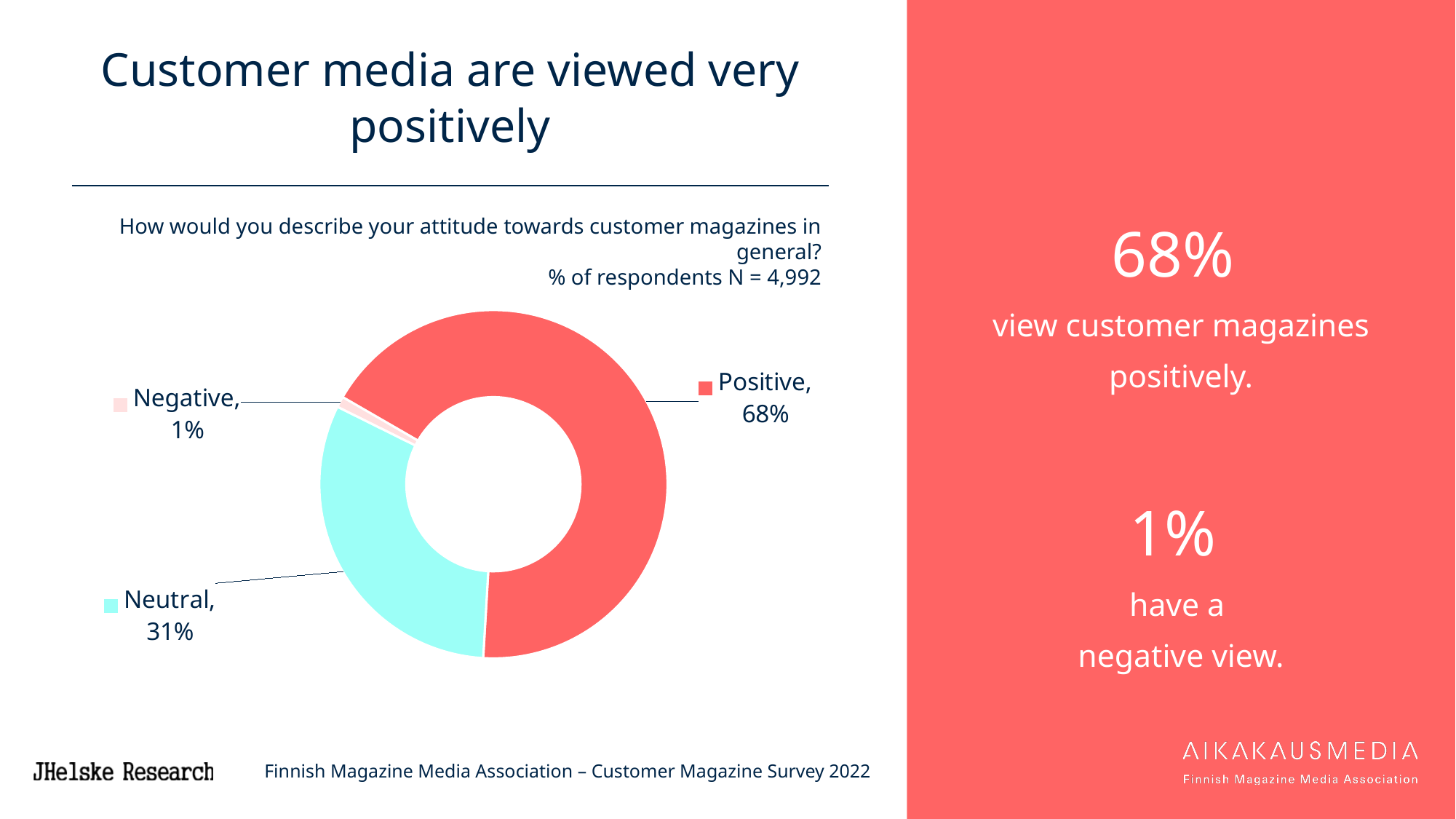
How many respondents (N) does the chart subtitle state? 4,992 Which is larger, the Neutral share or the Negative share? Neutral Which attitude category has the smallest share of respondents? Negative What percentage of respondents are neutral towards customer magazines? 31% What percentage of respondents have a negative attitude towards customer magazines? 1% What percentage of respondents have a positive attitude towards customer magazines? 68% What colour is the Neutral segment of the chart? Light blue (cyan) What is the difference in percentage points between the Positive and Neutral shares? 37 What is the difference in percentage points between the Neutral and Negative shares? 30 Which attitude category has the largest share of respondents? Positive How many attitude categories are shown in the chart? 3 What kind of chart is used to show the attitudes towards customer magazines? Pie chart (doughnut)